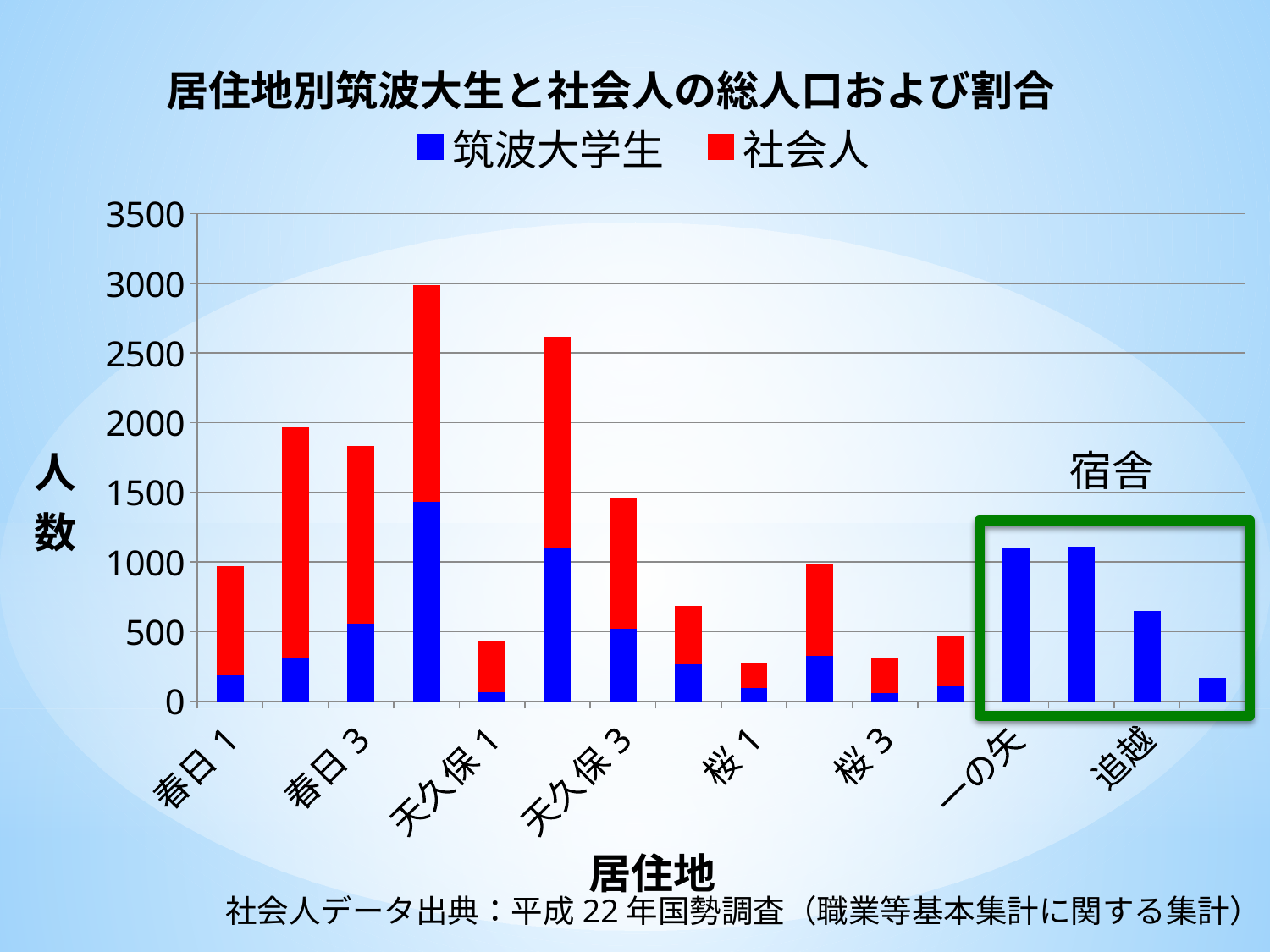
What kind of chart is shown on the slide? Stacked bar chart What are the two series named in the legend? 筑波大学生 and 社会人 Is the value for 一の矢 greater or less than 1000? greater Which has the larger total, 春日1 or 天久保1? 春日1 Is the total value for 春日1 greater or less than 500? greater What is the title of the chart? 居住地別筑波大生と社会人の総人口および割合 Is the value for 追越 greater or less than 500? greater How many bars are plotted in the chart? 16 How many series does the legend list? 2 Which has the larger value, 一の矢 or 追越? 一の矢